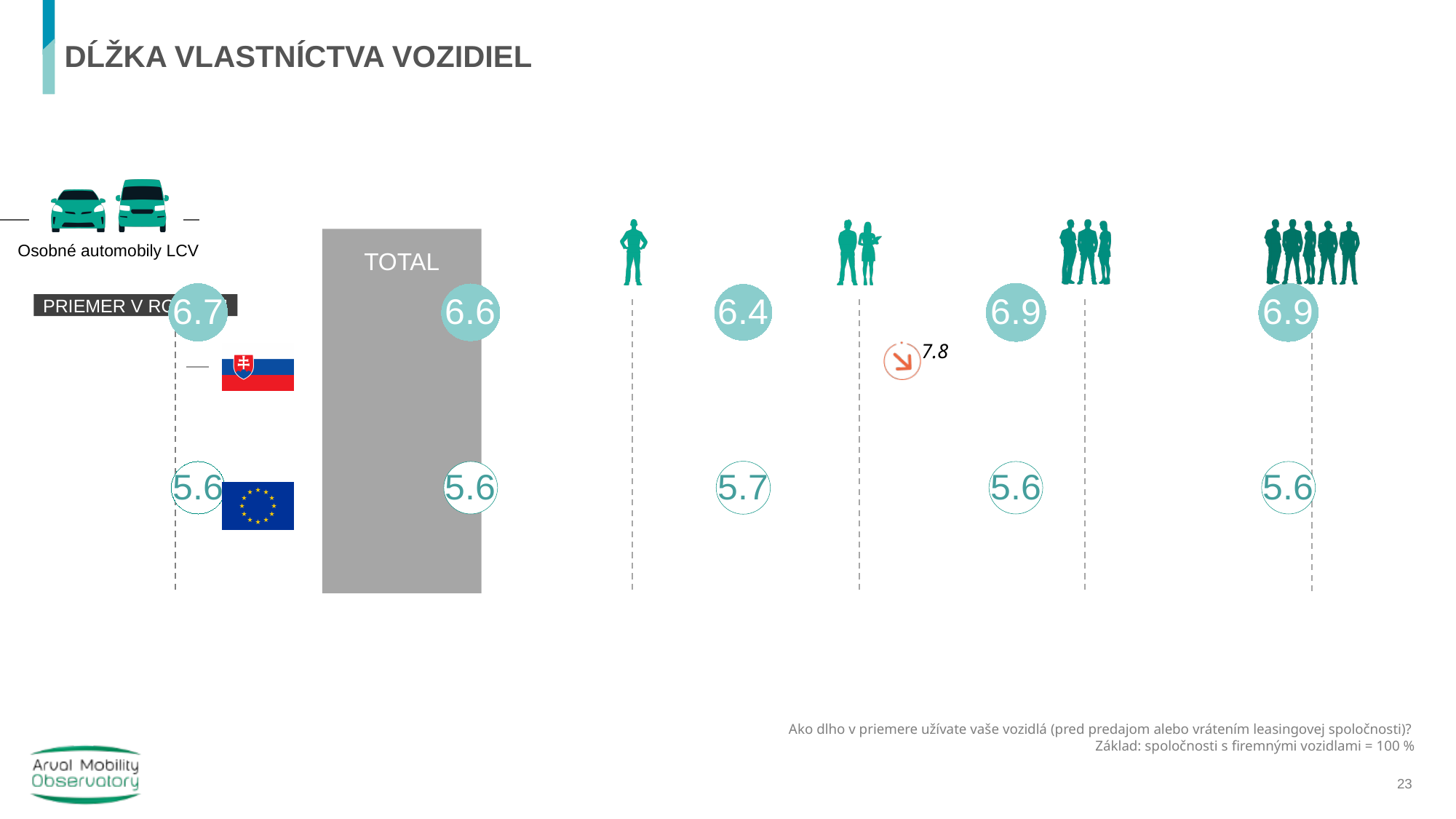
What is the TOTAL value shown in the top row (Slovak flag row)? 6.6 In the top row (Slovak flag), what value is shown in the rightmost column (group of five people icon)? 6.9 What is the difference between the Slovak TOTAL value (6.6) and the EU TOTAL value (5.6)? 1.0 What is the TOTAL value shown in the bottom row (EU flag row)? 5.6 In the bottom row (EU flag), what value is shown in the column with the single-person icon? 5.7 In the top row (Slovak flag), what value is shown in the column with the single-person icon? 6.4 What is the highest value shown in the bottom row (EU flag)? 5.7 What value is printed next to the small downward-arrow indicator below the two-person column? 7.8 What is the title of the slide? DĹŽKA VLASTNÍCTVA VOZIDIEL What is the lowest value shown in the top row (Slovak flag) across the four company-size columns? 6.4 Which is larger: the Slovak value in the single-person column or the EU value in the single-person column? Slovak value (6.4)